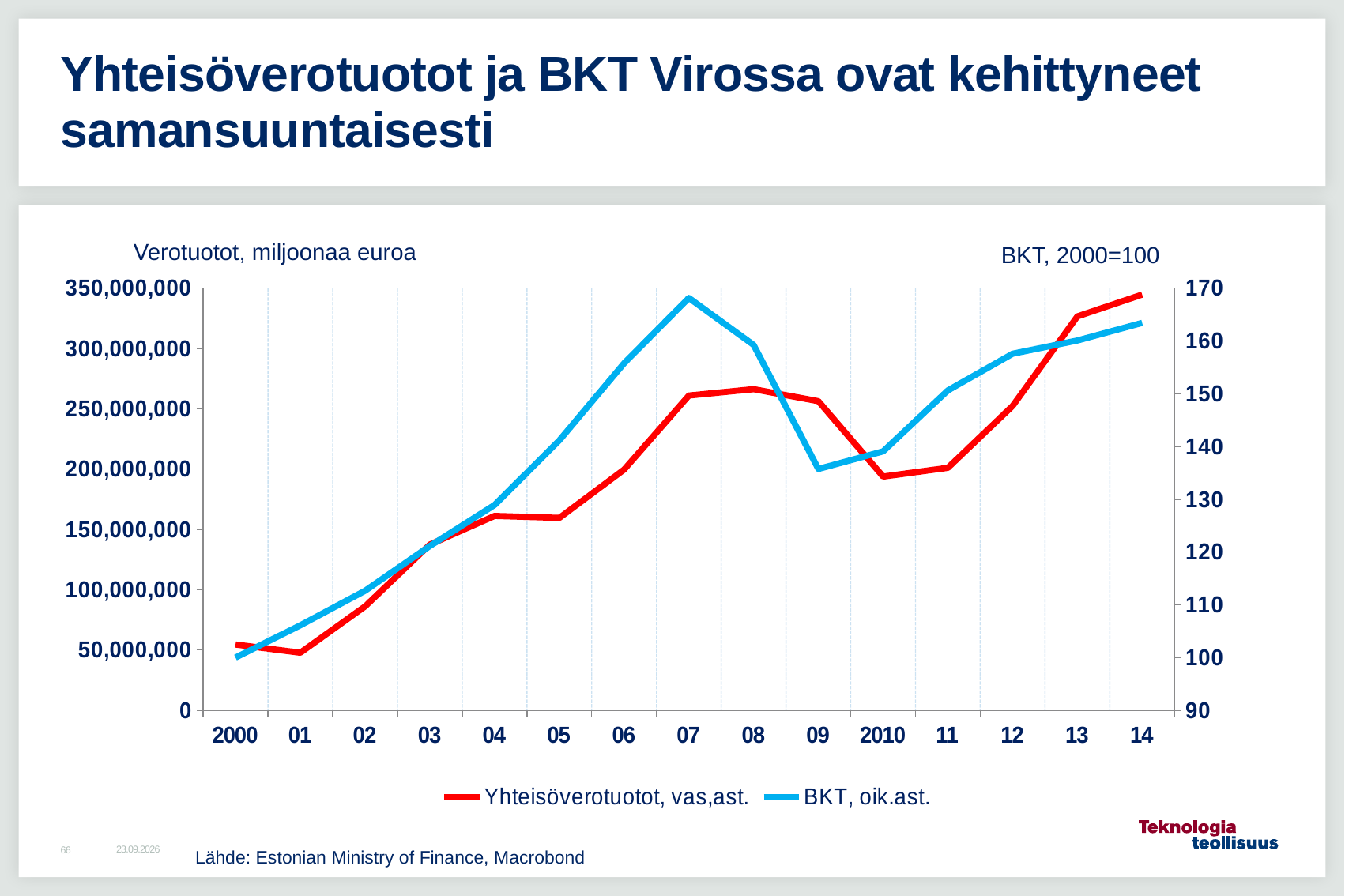
How many series does the legend list? 2 In which year does the BKT series reach its highest value? 07 Is the value for Yhteisöverotuotot in 2010 greater or less than 250,000,000? less In which year does the Yhteisöverotuotot series reach its highest value? 14 Which is larger for Yhteisöverotuotot: the value in 08 or the value in 13? 13 Is the value for Yhteisöverotuotot in 14 greater or less than 300,000,000? greater In which year is the BKT series at its lowest value? 2000 What is the title of the right-hand axis? BKT, 2000=100 What kind of chart is shown on the slide? line chart How many years are plotted along the x axis? 15 Is the value for BKT in 09 greater or less than 140? less Does the BKT series rise or fall between 07 and 09? fall